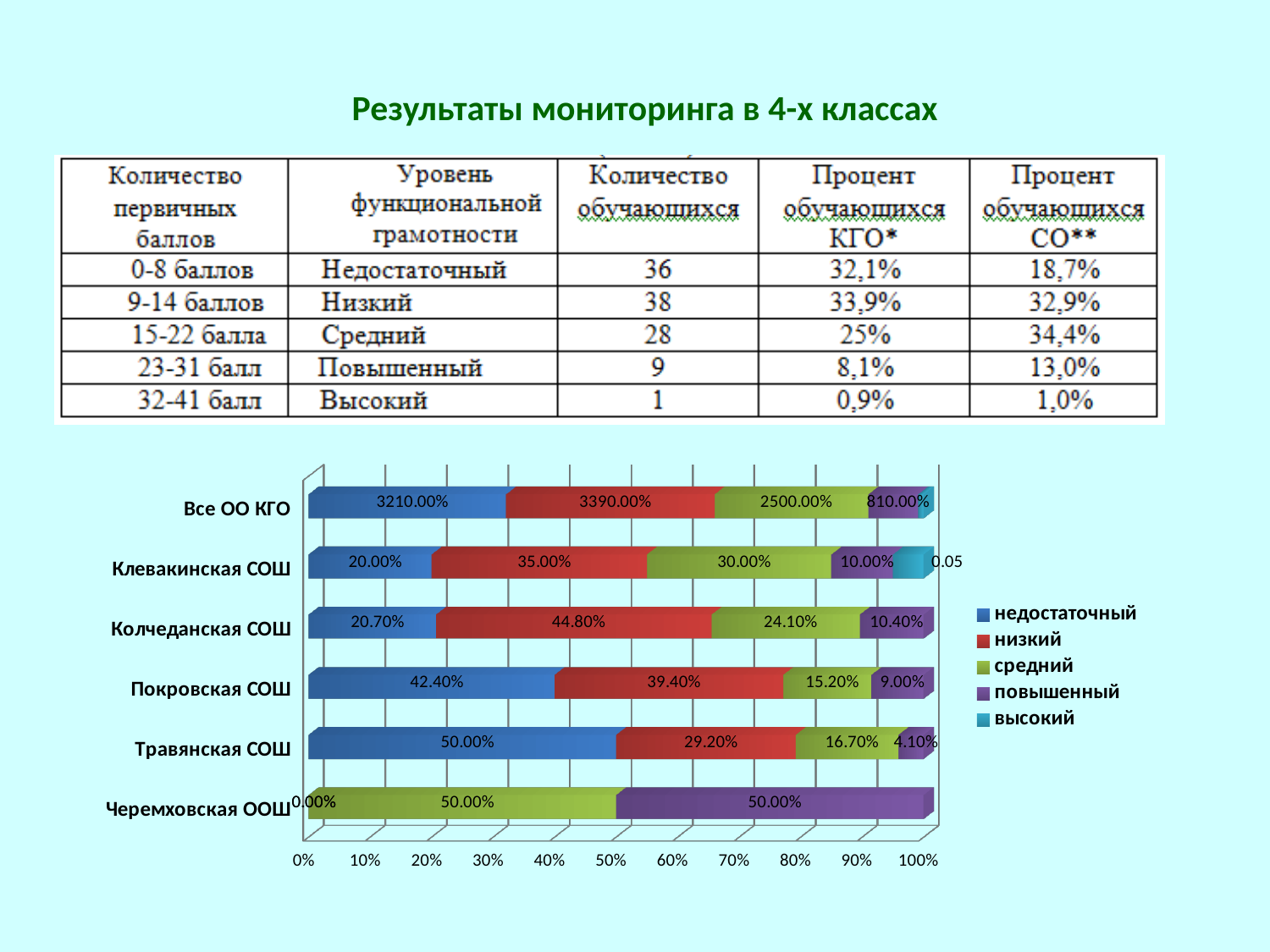
How many series does the chart legend list? 5 Which is larger for Клевакинская СОШ: the 'низкий' segment or the 'средний' segment? низкий What is the value of the 'повышенный' segment for Клевакинская СОШ? 10.00% Which series is shown in red in the chart legend? низкий What is the value of the 'средний' segment for Покровская СОШ? 15.20% What is the value of the 'недостаточный' segment for Травянская СОШ? 50.00% How many schools/categories are plotted on the chart? 6 Which school has the highest 'недостаточный' value among the individual schools? Травянская СОШ What kind of chart is shown on the slide? Stacked bar chart Which school has the lowest 'повышенный' value among the individual schools? Травянская СОШ What is the difference between the 'недостаточный' and 'низкий' values for Покровская СОШ? 3.00% What is the value of the 'низкий' segment for Колчеданская СОШ? 44.80%